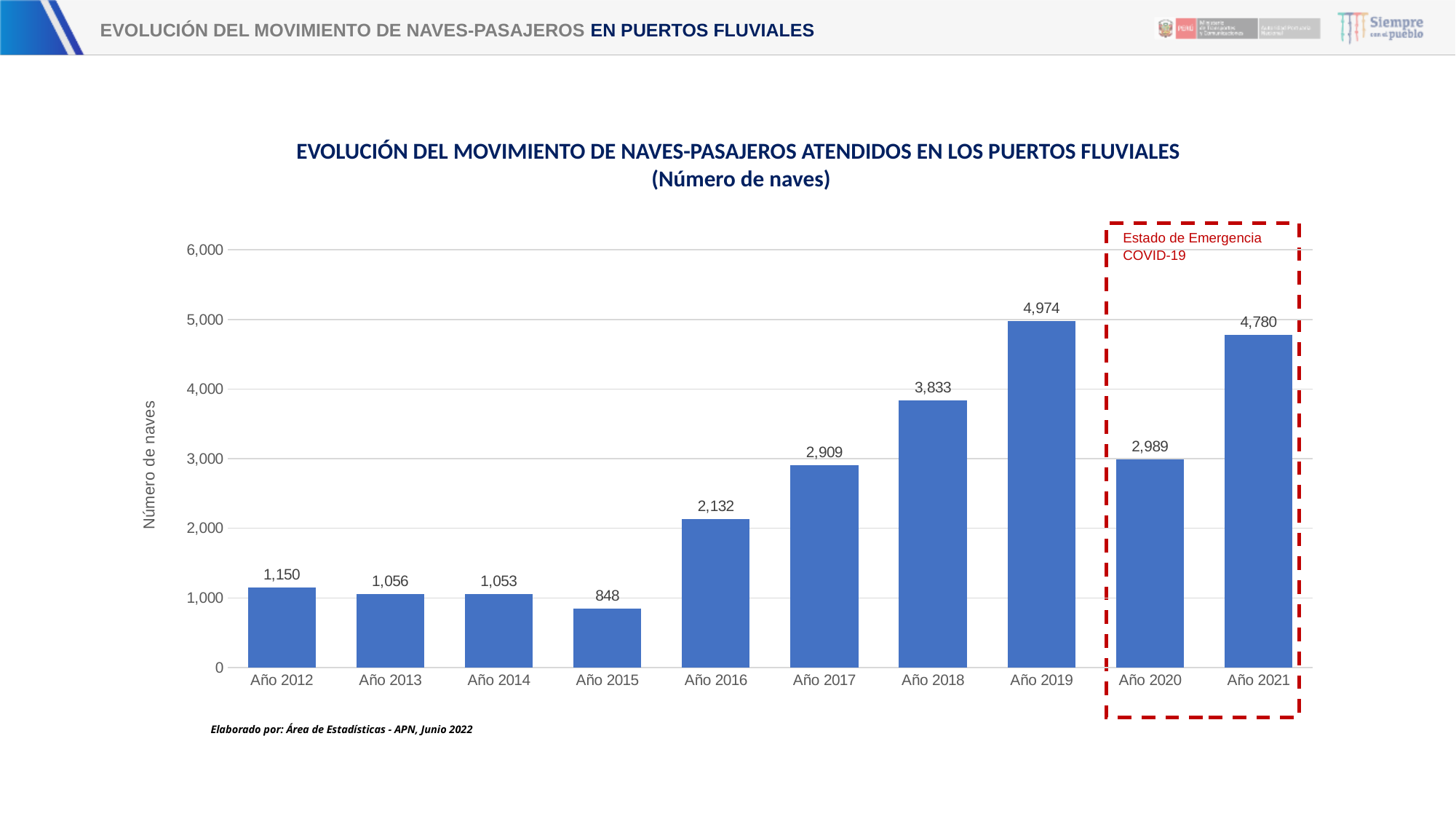
What does the red dashed box on the chart label? Estado de Emergencia COVID-19 What is the difference in number of naves between Año 2019 and Año 2020? 1,985 Which year has the highest number of naves? Año 2019 Is the value for Año 2016 greater or less than 2,000? greater How many years are shown on the x axis? 10 What is the number of naves for Año 2020? 2,989 What is the number of naves for Año 2019? 4,974 Which is larger, the number of naves for Año 2017 or for Año 2018? Año 2018 What kind of chart is shown on the slide? Bar chart What is the difference in number of naves between Año 2021 and Año 2020? 1,791 Which year has the lowest number of naves? Año 2015 What is the number of naves for Año 2015? 848